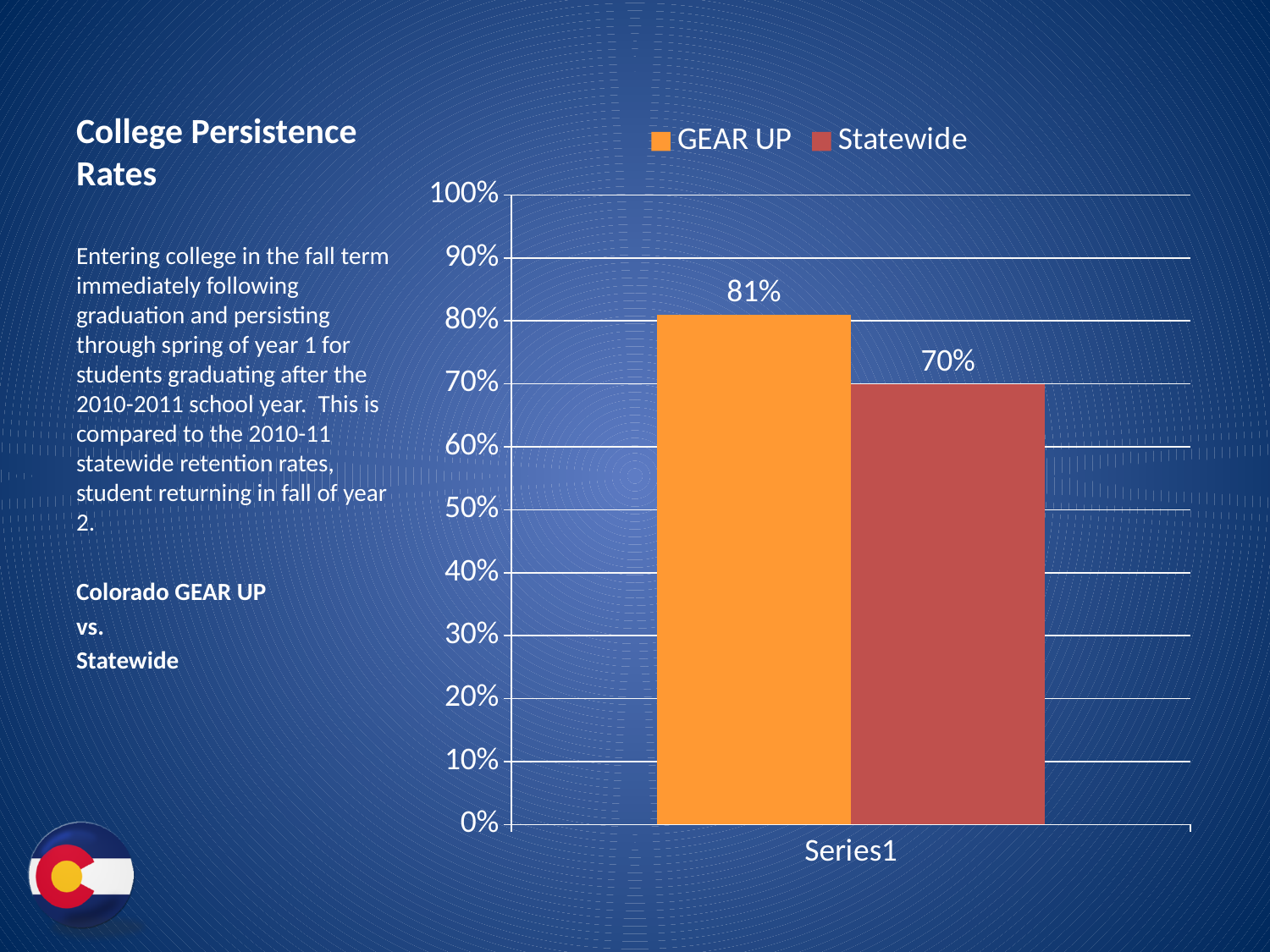
Is the value for GEAR UP greater or less than 80%? greater How many series does the legend list? 2 What colour is the GEAR UP bar? orange Which series has the lower value, GEAR UP or Statewide? Statewide Is the value for Statewide greater or less than 80%? less Which series has the higher value, GEAR UP or Statewide? GEAR UP Is the GEAR UP value larger or smaller than the Statewide value? larger What is the college persistence rate for Statewide? 70% What kind of chart is shown on the slide? bar chart What is the difference between the GEAR UP and Statewide values? 11% What is the college persistence rate for GEAR UP? 81% What is the label on the x axis under the bars? Series1